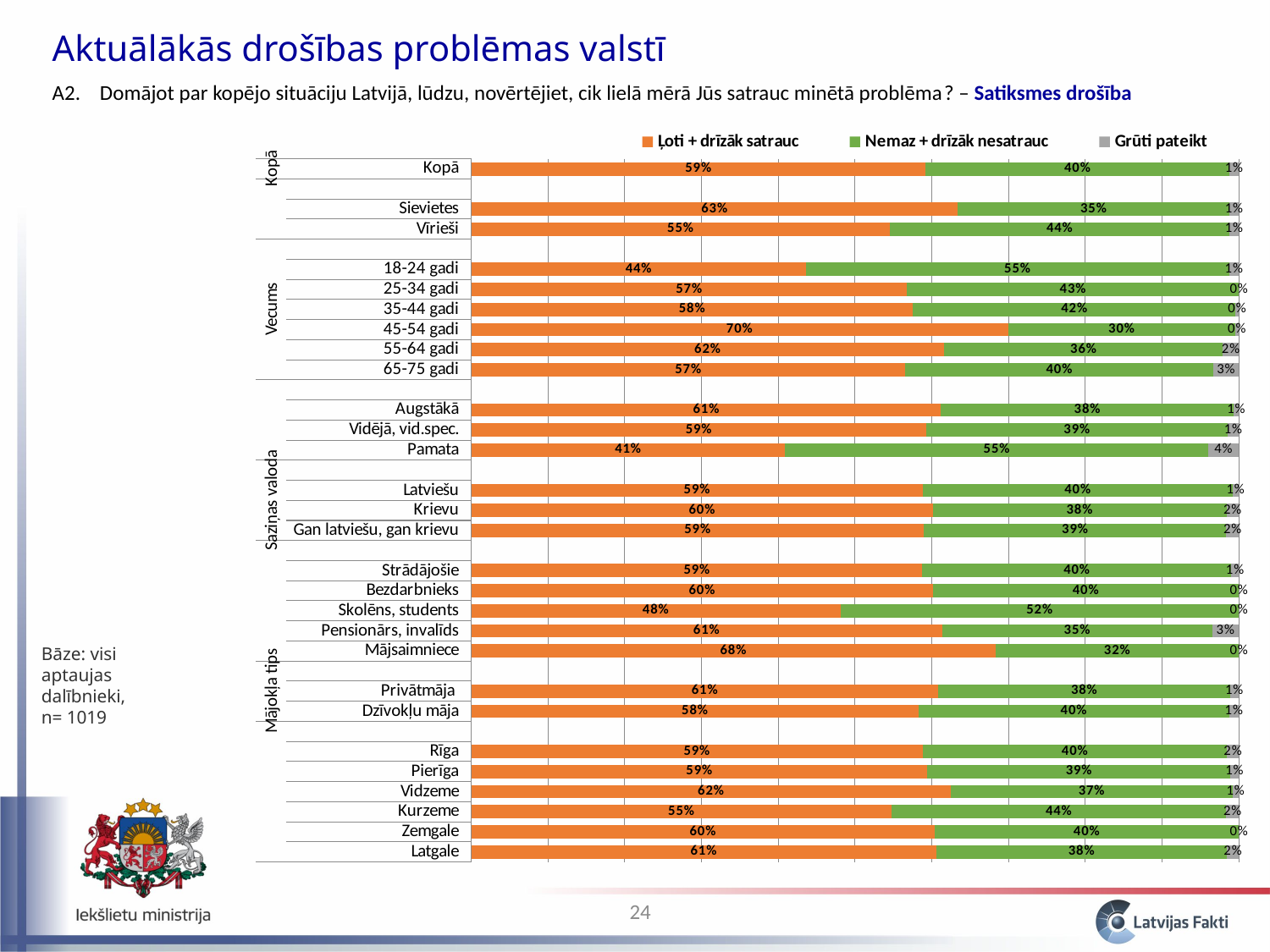
What is the total of the stacked bar for 'Kopā'? 100% How many categories are plotted in the chart? 28 What is the difference in the 'Ļoti + drīzāk satrauc' value between 'Sievietes' and 'Vīrieši'? 8 percentage points Which has a higher 'Nemaz + drīzāk nesatrauc' value, 'Mājsaimniece' or 'Skolēns, students'? Skolēns, students How many series does the legend list? 3 What kind of chart is shown on the slide? Stacked bar chart What is the 'Grūti pateikt' value for 'Pamata'? 4% Which category has the lowest 'Ļoti + drīzāk satrauc' value? Pamata Which category has the highest 'Ļoti + drīzāk satrauc' value? 45-54 gadi Which has a higher 'Ļoti + drīzāk satrauc' value, 'Rīga' or 'Vidzeme'? Vidzeme What percentage of respondents in the 'Kopā' category answered 'Ļoti + drīzāk satrauc'? 59% What is the 'Nemaz + drīzāk nesatrauc' value for 'Vīrieši'? 44%